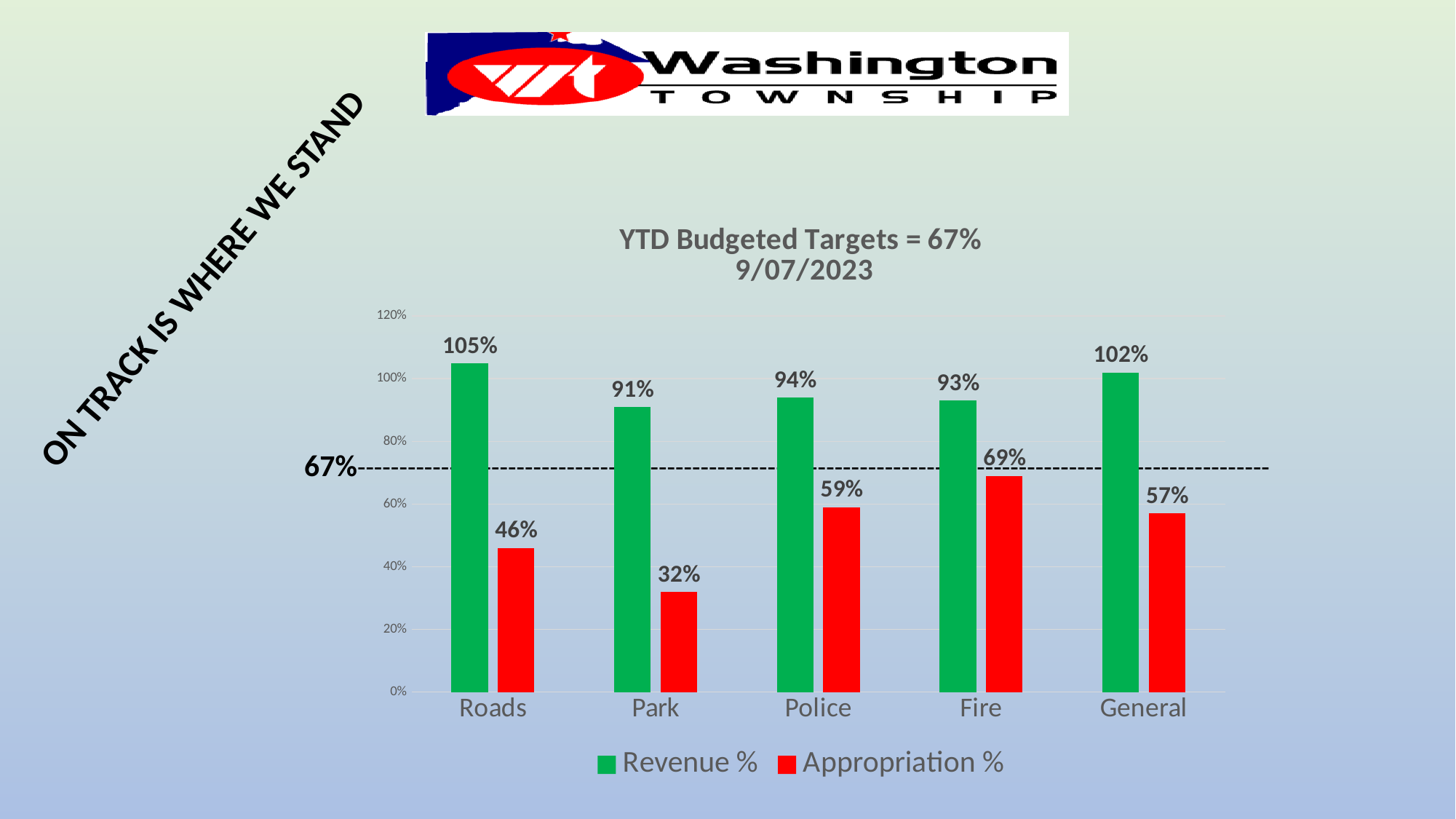
Which category has the highest Revenue %? Roads Which is larger, the Appropriation % for Fire or the Appropriation % for General? Fire What is the difference between the Revenue % and the Appropriation % for Police? 35% What is the Revenue % for Roads? 105% What is the title of the chart? YTD Budgeted Targets = 67% 9/07/2023 How many categories are shown on the x axis? 5 Which category has the lowest Appropriation %? Park What is the Appropriation % for Park? 32% What kind of chart is shown on the slide? bar chart What is the Appropriation % for Fire? 69% Is the Appropriation % for Roads greater or less than 60%? less How many series does the legend list? 2